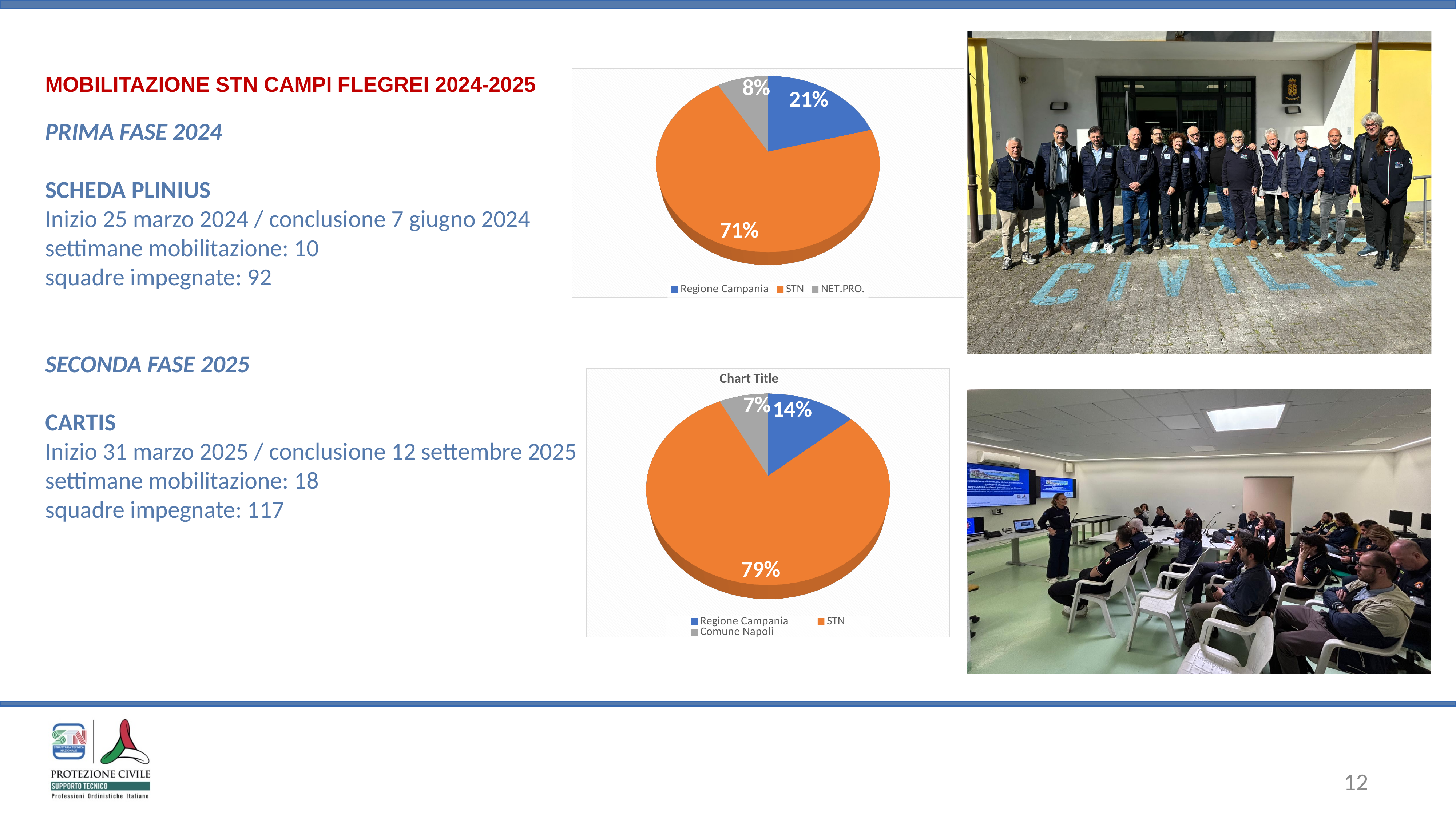
In the lower pie chart titled 'Chart Title', which is larger, the Regione Campania slice or the Comune Napoli slice? Regione Campania In the lower pie chart titled 'Chart Title', what share does Comune Napoli have? 7% In the upper pie chart, what share does STN have? 71% How many categories does the legend of the lower pie chart list? 3 In the lower pie chart titled 'Chart Title', what share does Regione Campania have? 14% In the upper pie chart, what share does NET.PRO. have? 8% In the upper pie chart, which category has the smallest slice? NET.PRO. In the upper pie chart, what is the difference between the STN share and the Regione Campania share? 50% In the lower pie chart titled 'Chart Title', what share does STN have? 79% In the upper pie chart, what share does Regione Campania have? 21% What kind of chart is the upper chart on the slide? Pie chart In the upper pie chart, which category has the largest slice? STN